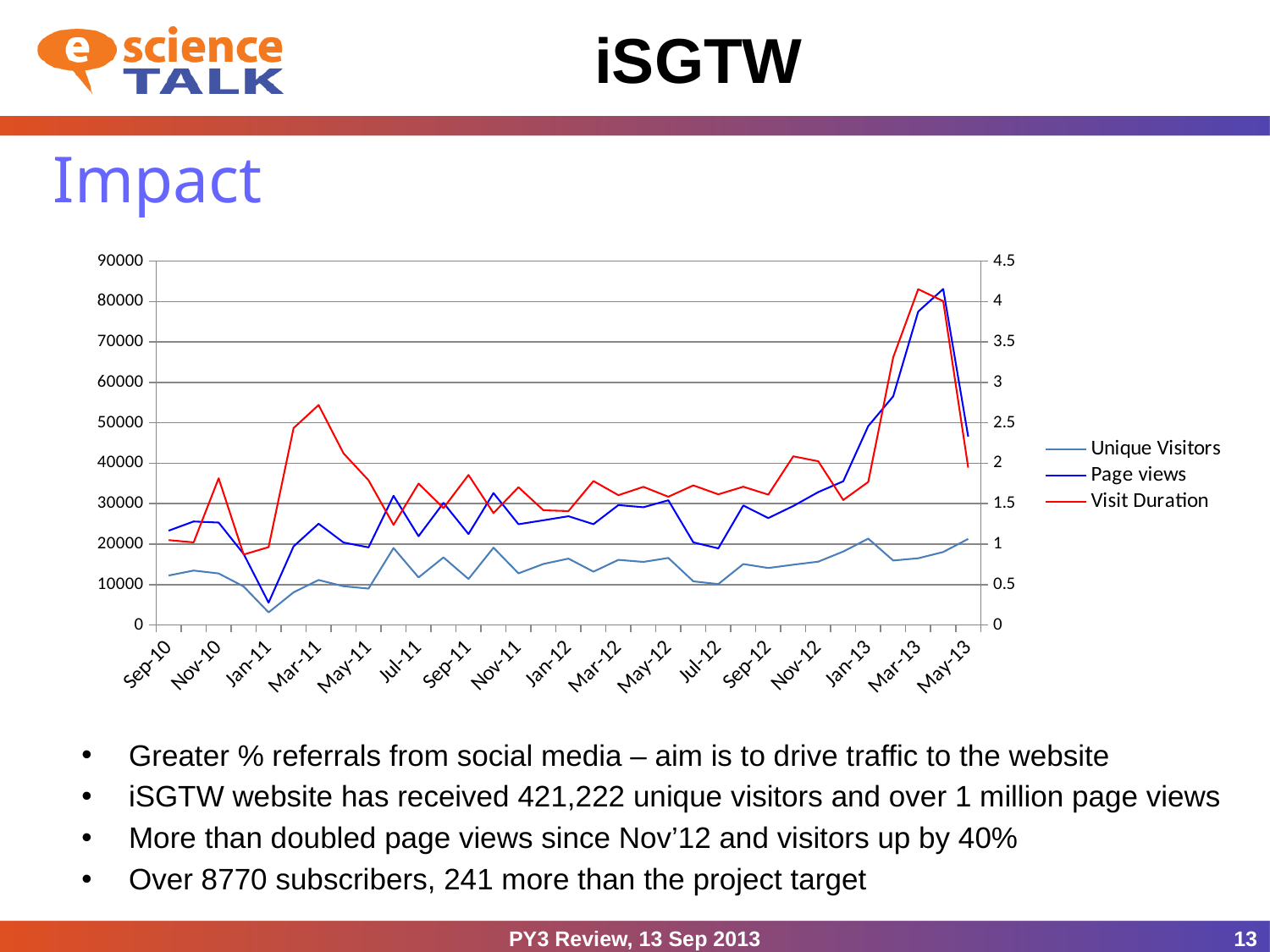
What kind of chart is shown on the slide? line chart Is the value for Unique Visitors at Jan-11 greater or less than 10000? less At which labelled month are Page views lowest? Jan-11 Which is larger at Mar-13: Page views or Unique Visitors? Page views Is the value for Page views at Jan-11 greater or less than 10000? less Which series are listed in the chart legend? Unique Visitors, Page views, Visit Duration How many series does the chart legend list? 3 Is the value for Visit Duration at Mar-13 greater or less than 4? greater How many month labels are shown on the x axis of the chart? 17 Do Page views rise or fall between Nov-12 and Mar-13? rise